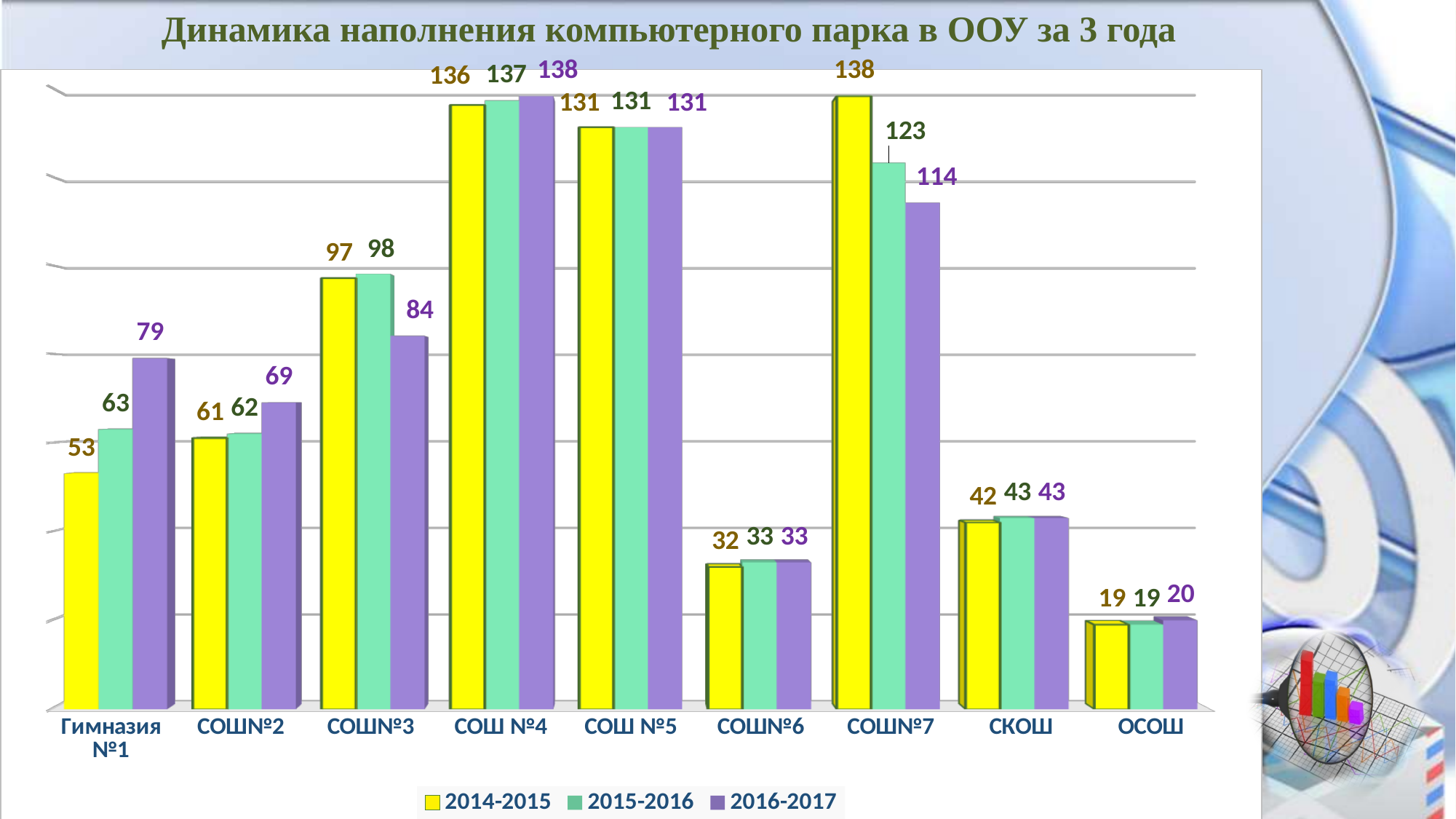
What colour are the bars for the 2014-2015 series? yellow Do the values for Гимназия №1 rise or fall from 2014-2015 to 2016-2017? rise What type of chart is shown on the slide? bar chart Which is larger for СОШ№3: the 2014-2015 value or the 2016-2017 value? 2014-2015 How many schools (categories) are shown on the x axis? 9 Which school has the highest value in 2016-2017? СОШ №4 What is the value for Гимназия №1 in 2016-2017? 79 What is the difference between the 2014-2015 and 2016-2017 values for СОШ№7? 24 What is the value for СОШ№7 in 2014-2015? 138 How many series does the legend list? 3 What is the value for СОШ№3 in 2015-2016? 98 Which school has the lowest value in 2014-2015? ОСОШ